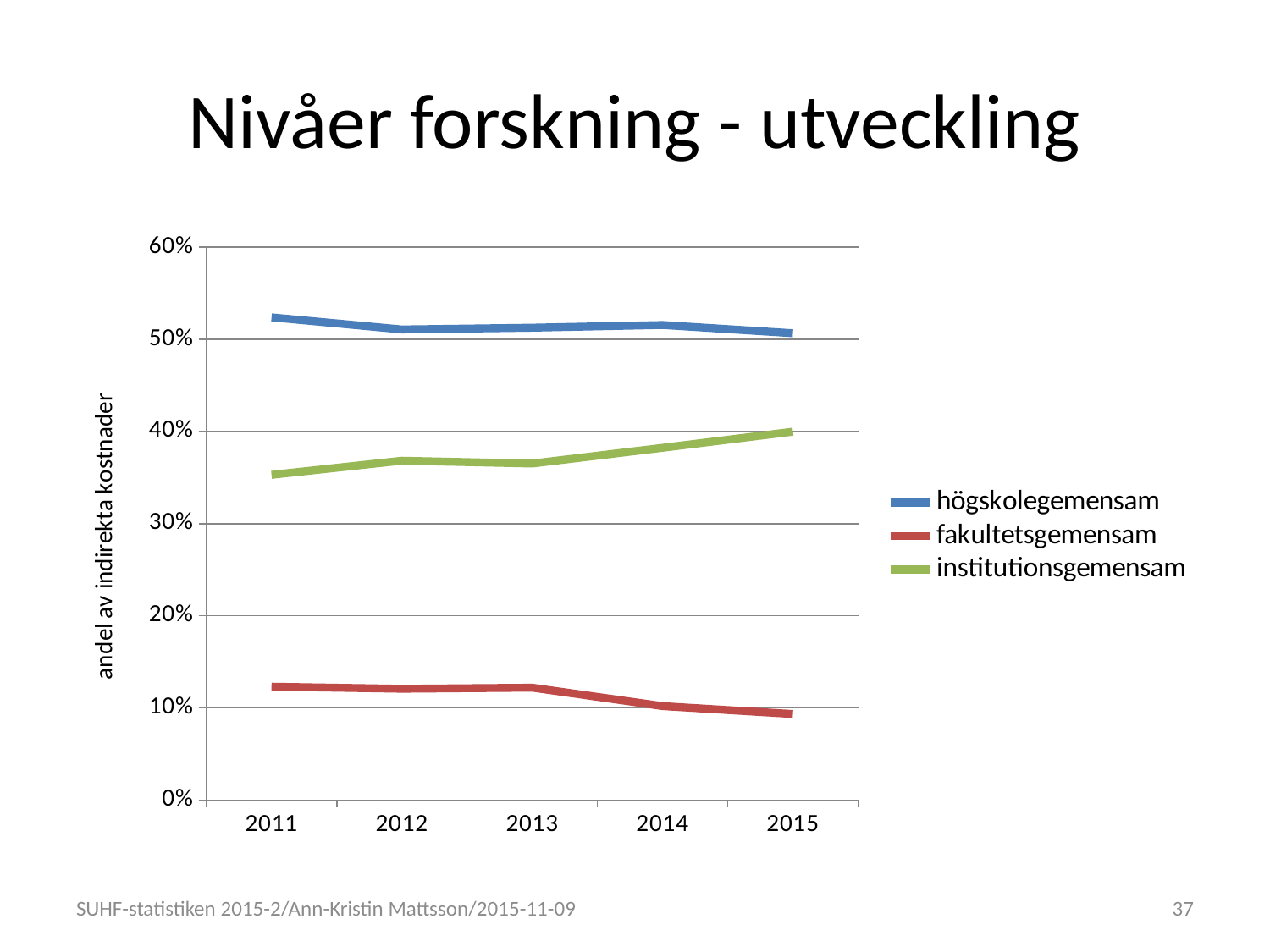
Which is larger in 2015: the value for högskolegemensam or the value for institutionsgemensam? högskolegemensam How many series does the legend list? 3 How many years are shown on the x axis? 5 Which series has the lowest values across all years? fakultetsgemensam Is the value for fakultetsgemensam in 2015 greater or less than 10%? less Is the value for institutionsgemensam in 2012 greater or less than 40%? less What kind of chart is shown on the slide? line chart What is the label on the vertical axis of the chart? andel av indirekta kostnader Does the value for fakultetsgemensam rise or fall from 2013 to 2015? fall Does the value for institutionsgemensam rise or fall from 2011 to 2015? rise Is the value for högskolegemensam in 2011 greater or less than 50%? greater Which series has the highest values across all years? högskolegemensam